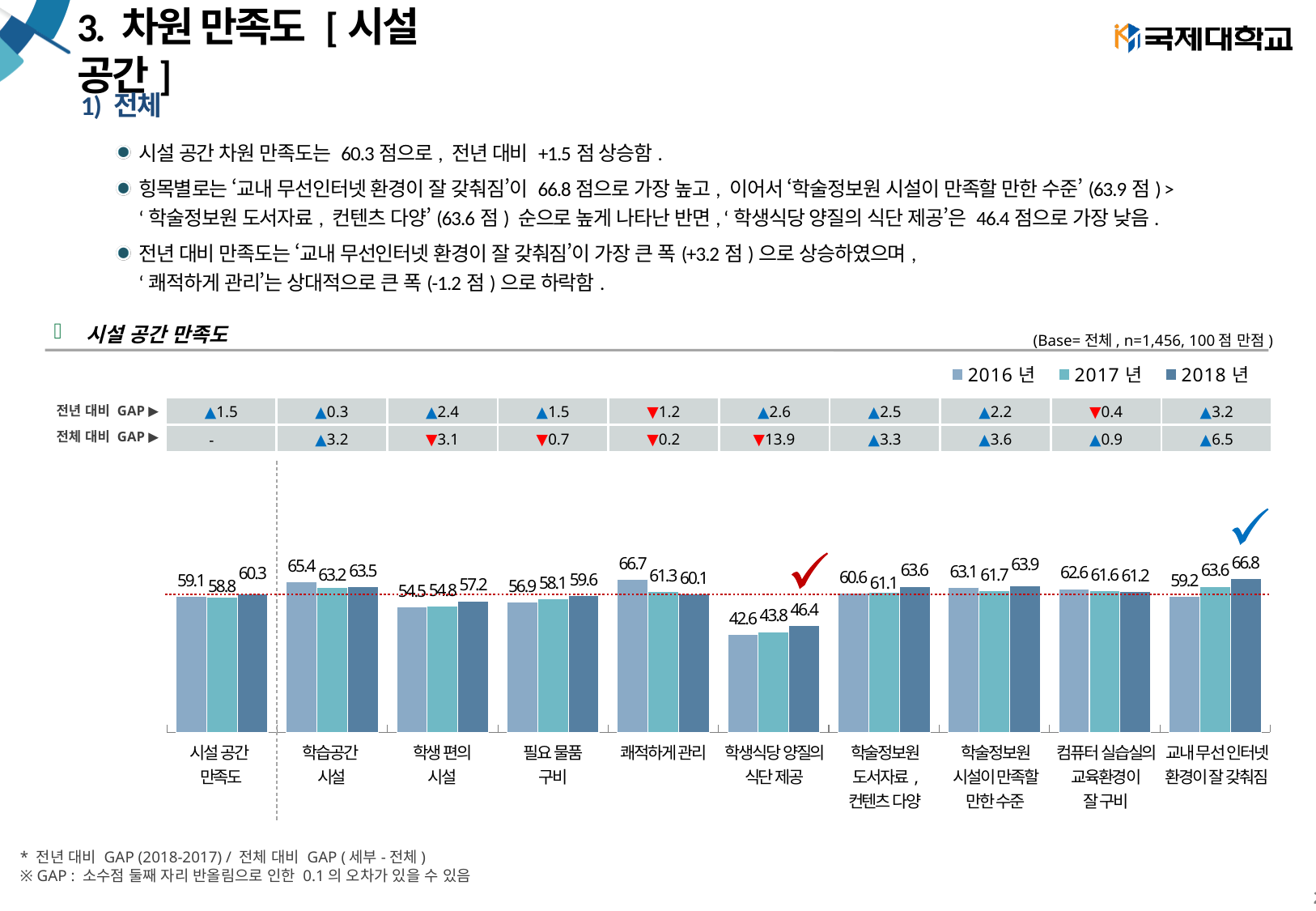
Which year does the darkest blue series in the legend represent? 2018년 Which is larger for '쾌적하게 관리': the 2016년 value or the 2018년 value? 2016년 What is the difference between the 2018년 and 2017년 values for '교내 무선인터넷 환경이 잘 갖춰짐'? 3.2 What type of chart is shown on the slide? bar chart How many series does the chart legend list? 3 What is the 2017년 value for '학생식당 양질의 식단 제공'? 43.8 What is the 2016년 value for '쾌적하게 관리'? 66.7 What is the 2018년 value for '교내 무선인터넷 환경이 잘 갖춰짐'? 66.8 Do the values for '학생 편의 시설' rise or fall from 2016년 to 2018년? rise Which category has the lowest 2018년 value? 학생식당 양질의 식단 제공 Which category has the highest 2018년 value? 교내 무선인터넷 환경이 잘 갖춰짐 How many categories are shown along the x axis of the chart? 10